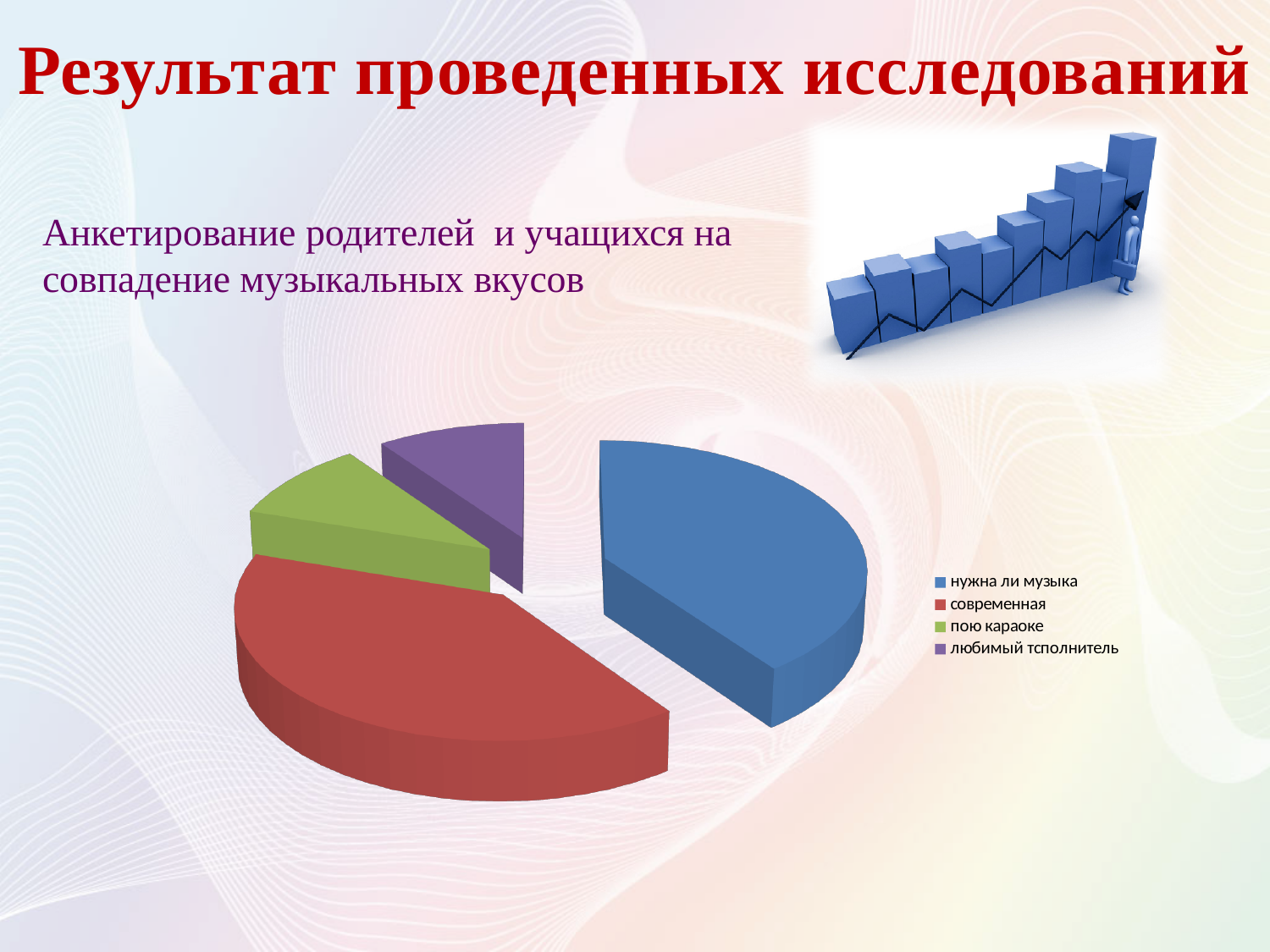
Which slice is larger in the pie chart, "нужна ли музыка" or "любимый тсполнитель"? нужна ли музыка Which slice is larger in the pie chart, "нужна ли музыка" or "пою караоке"? нужна ли музыка What kind of chart is shown on the slide? pie chart How many slices does the pie chart have? 4 Which legend entry of the pie chart is shown in purple? любимый тсполнитель How many entries does the legend of the pie chart list? 4 Which slice is larger in the pie chart, "современная" or "любимый тсполнитель"? современная What colour is the "пою караоке" slice in the pie chart? green